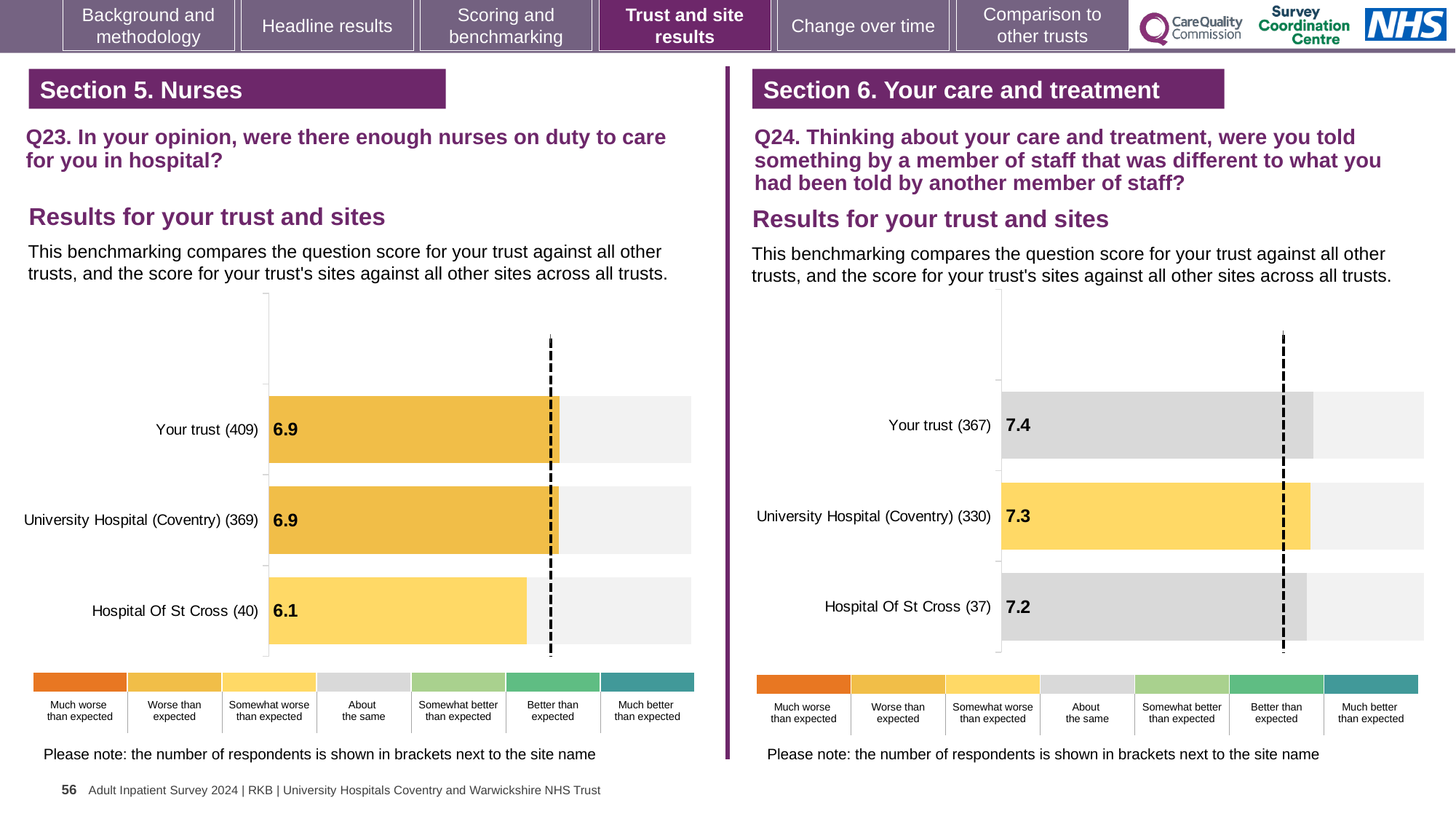
In the Q24 chart on the right, what is the difference between the scores for Your trust (367) and Hospital Of St Cross (37)? 0.2 In the Q24 chart on the right, what is the score for Your trust (367)? 7.4 In the Q24 chart on the right, what is the score for University Hospital (Coventry) (330)? 7.3 What type of chart is used in the Q23 chart on the left? Bar chart In the Q24 chart on the right, what is the score for Hospital Of St Cross (37)? 7.2 In the Q23 chart on the left, how many bars are plotted? 3 In the Q23 chart on the left, which site has the lowest score? Hospital Of St Cross (40) In the Q24 chart on the right, which bar has the highest score? Your trust (367) In the Q23 chart on the left, what is the score for Your trust (409)? 6.9 In the Q23 chart on the left, what is the difference between the scores for University Hospital (Coventry) (369) and Hospital Of St Cross (40)? 0.8 In the Q23 chart on the left, what is the score for Hospital Of St Cross (40)? 6.1 In the Q24 chart on the right, which benchmark category does the colour of the University Hospital (Coventry) (330) bar correspond to in the legend? Somewhat worse than expected